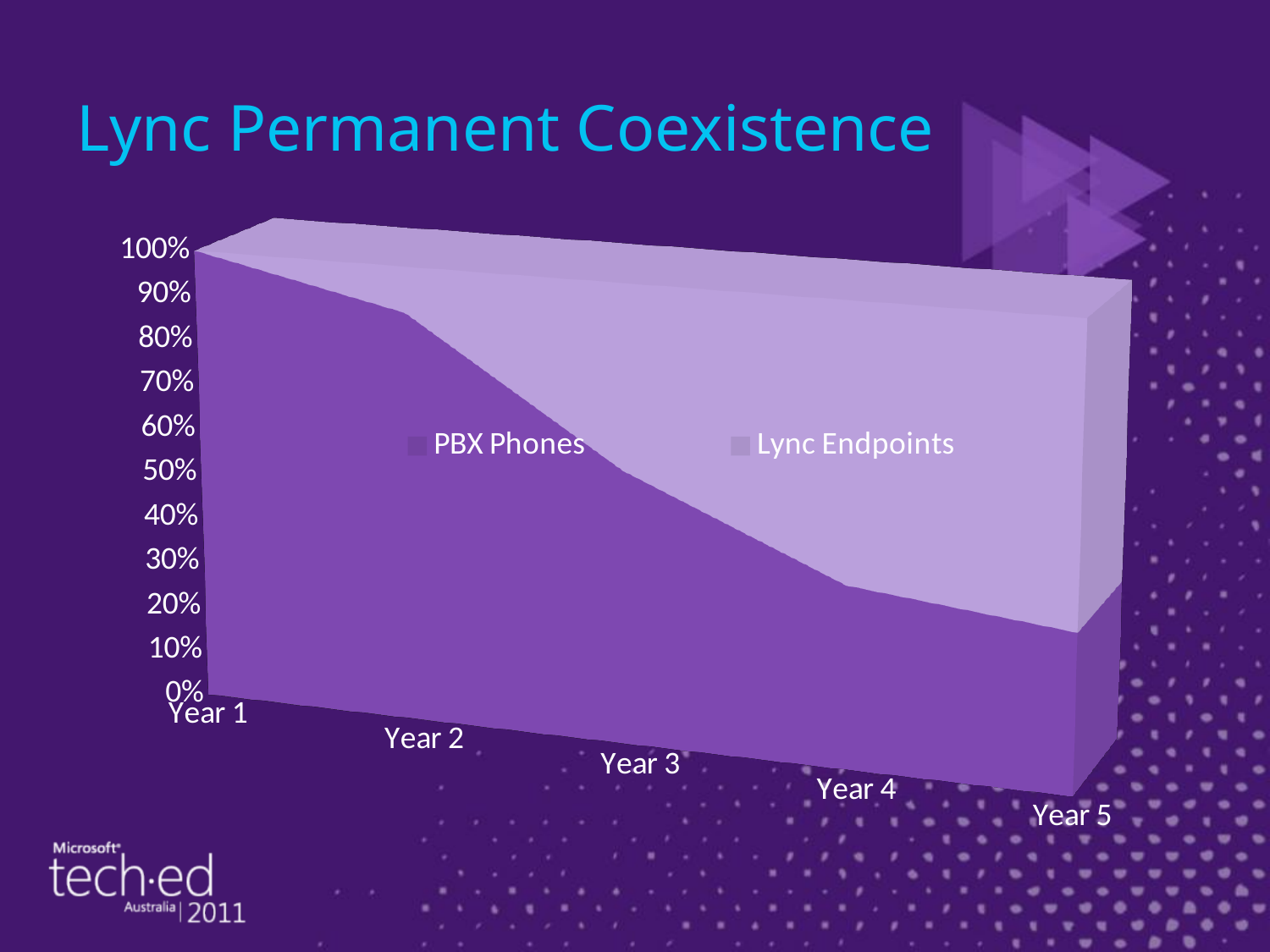
Does the share of PBX Phones rise or fall from Year 1 to Year 5? Fall What are the two series named in the legend? PBX Phones and Lync Endpoints How many series does the legend list? 2 In Year 5, which series has the larger share, PBX Phones or Lync Endpoints? Lync Endpoints What is the title of the chart? Lync Permanent Coexistence In Year 1, which series has the larger share, PBX Phones or Lync Endpoints? PBX Phones In which year is the share of PBX Phones highest? Year 1 Is the share of PBX Phones in Year 4 greater or less than 50%? less Does the share of Lync Endpoints rise or fall from Year 1 to Year 5? Rise What kind of chart is shown on the slide? Area chart In which year is the share of PBX Phones lowest? Year 5 How many years are shown along the x axis? 5